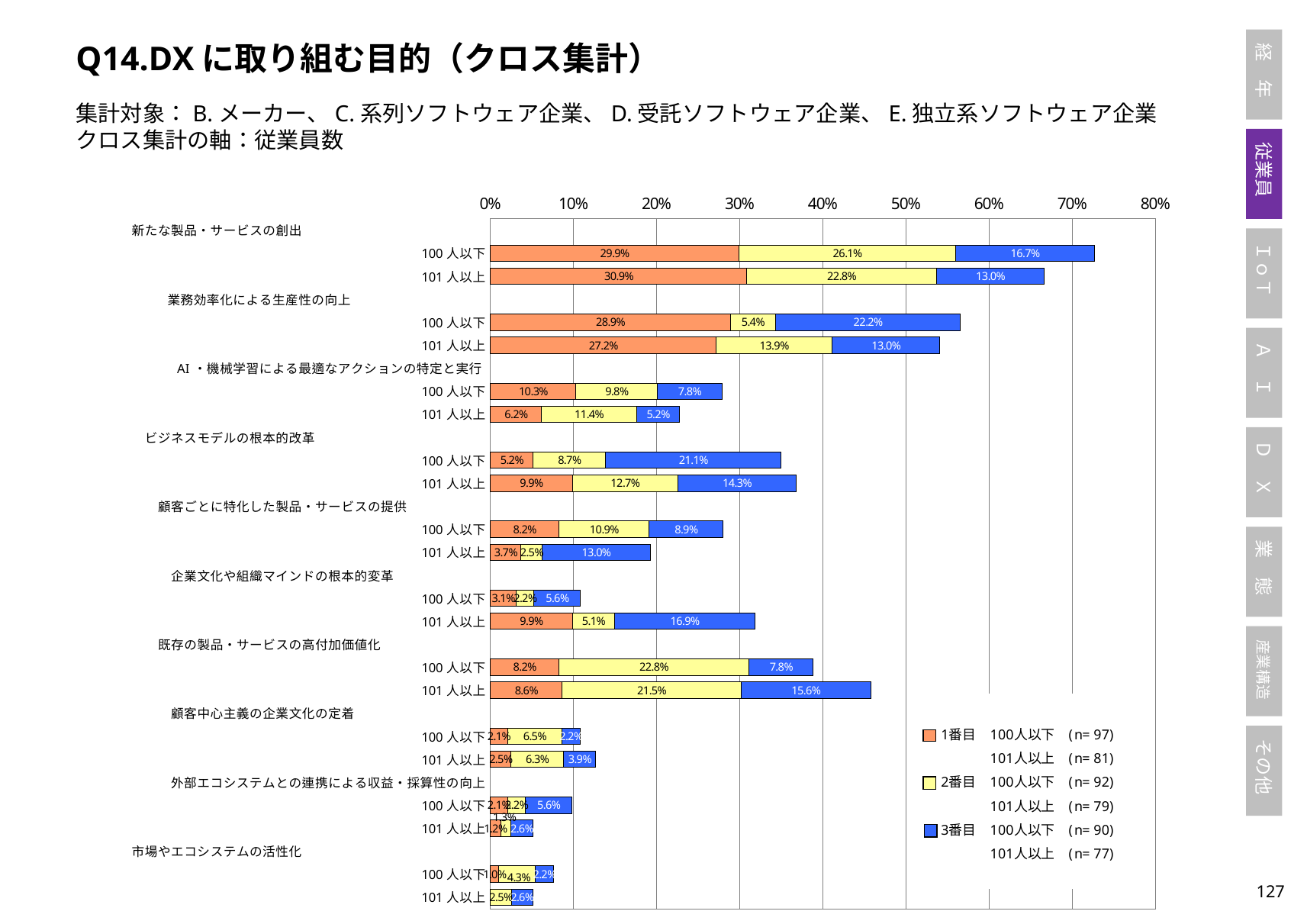
What is the difference between the 1番目 values for 100人以下 and 101人以上 in AI・機械学習による最適なアクションの特定と実行? 4.1% Is the total stacked bar for 101人以上 in 新たな製品・サービスの創出 greater or less than 60%? greater What kind of chart is shown on the slide? Stacked bar chart What is the sample size (n) for 100人以下 in the 1番目 series according to the legend? 97 What is the 1番目 value for 100人以下 in 新たな製品・サービスの創出? 29.9% What is the 2番目 value for 101人以上 in 既存の製品・サービスの高付加価値化? 21.5% How many series does the legend list? 3 What is the total of the stacked bar for 100人以下 in 新たな製品・サービスの創出? 72.7% Which category has the longest stacked bar for 100人以下? 新たな製品・サービスの創出 Which is larger, the 3番目 value for 100人以下 or for 101人以上 in ビジネスモデルの根本的改革? 100人以下 What is the total of the stacked bar for 101人以上 in 業務効率化による生産性の向上? 54.1% What is the 3番目 value for 100人以下 in 業務効率化による生産性の向上? 22.2%